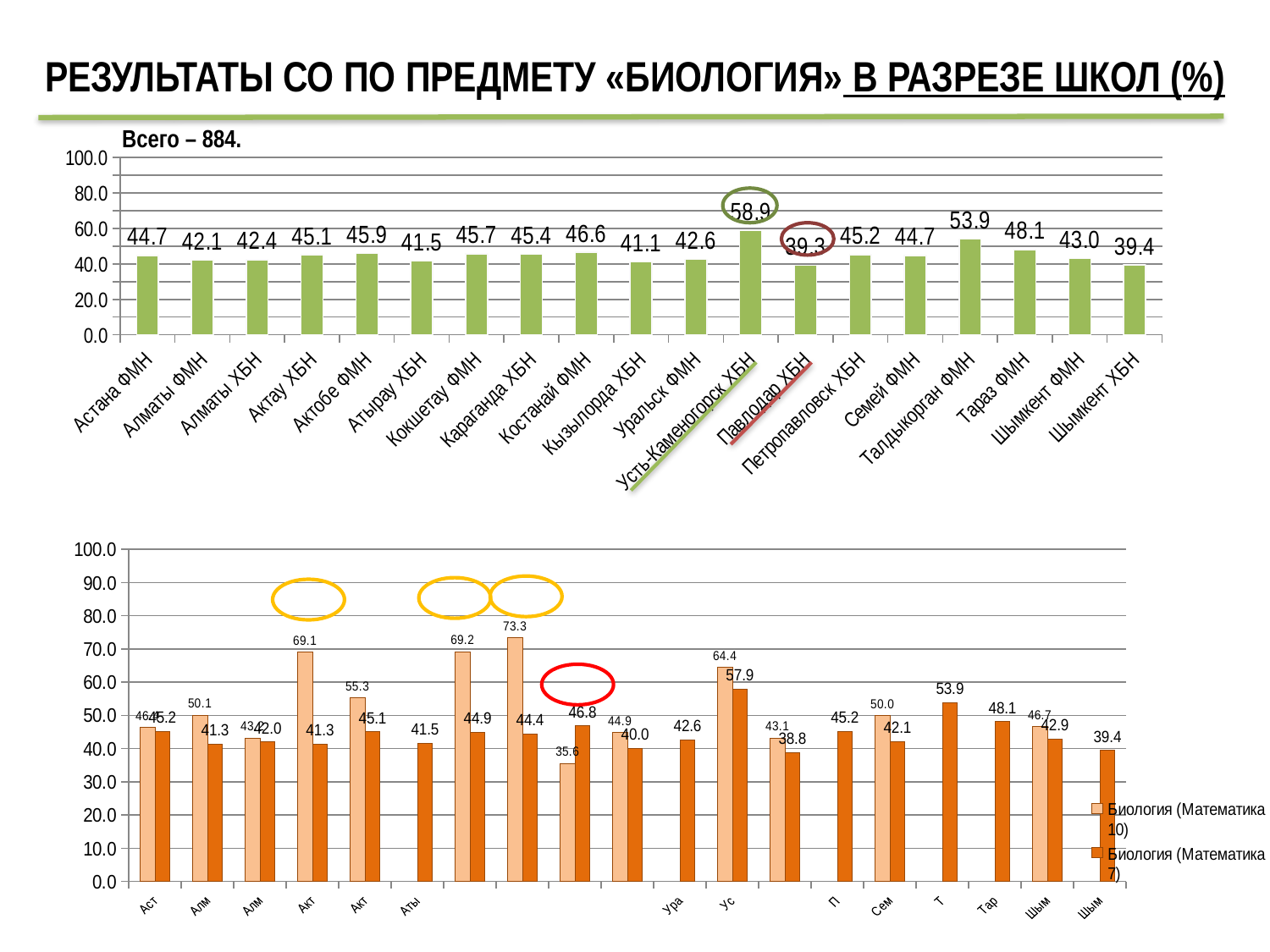
In the top chart, what is the difference between the values for Усть-Каменогорск ХБН and Павлодар ХБН? 19.6 In the top chart, is the value for Талдыкорган ФМН greater or less than 60.0? less In the top chart, which school has the highest value? Усть-Каменогорск ХБН How many series does the legend of the bottom chart list? 2 How many schools are shown in the top chart? 19 In the top chart, which is larger: the value for Тараз ФМН or the value for Костанай ФМН? Тараз ФМН What type of chart is the top chart? bar chart In the top chart, which school has the lowest value? Павлодар ХБН In the top chart, what is the value for Павлодар ХБН? 39.3 In the top chart, what is the value for Усть-Каменогорск ХБН? 58.9 What total is stated above the top chart? Всего – 884. In the top chart, what is the value for Талдыкорган ФМН? 53.9